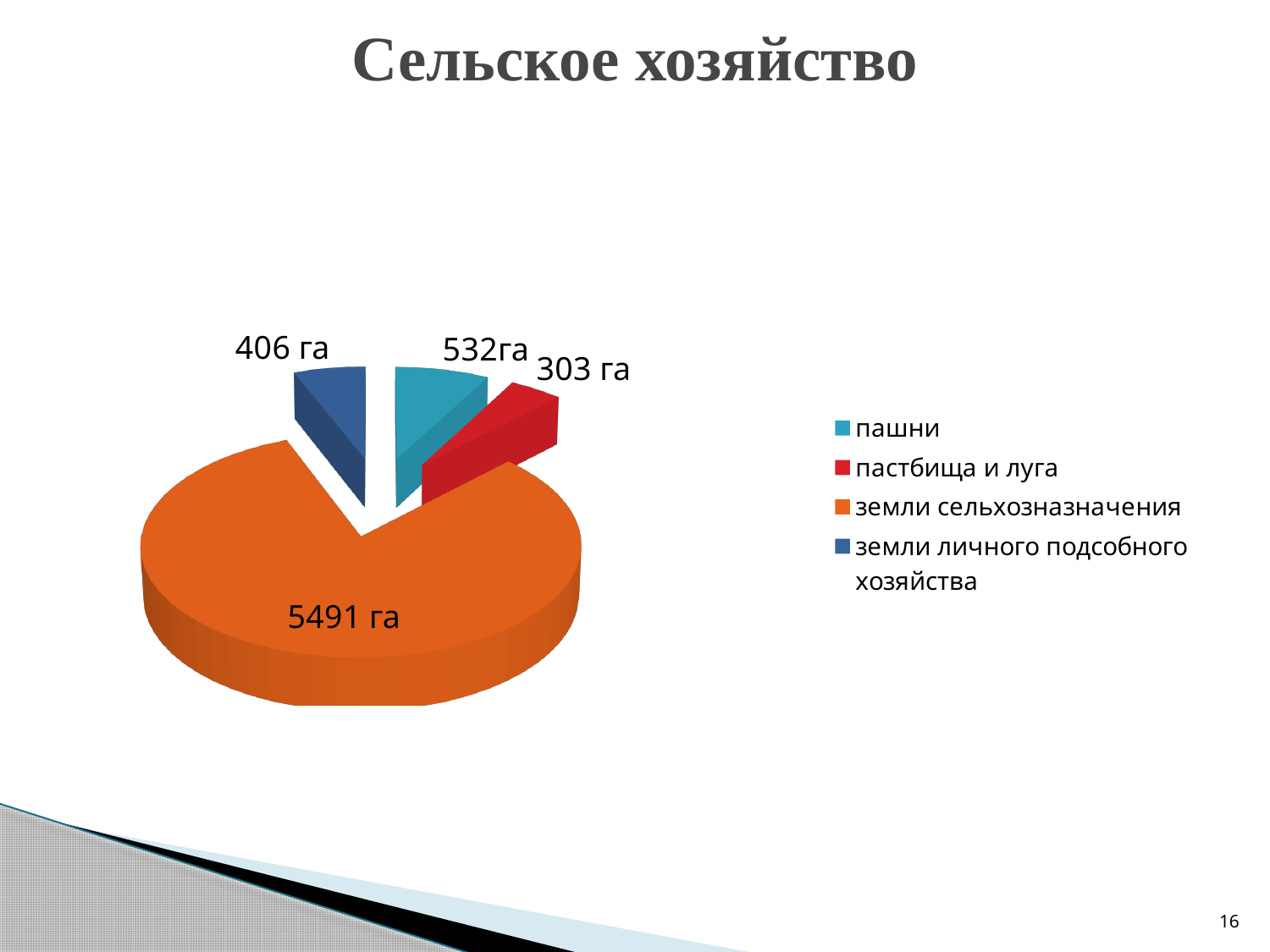
What type of chart is shown on the slide? pie chart What is the value shown for земли личного подсобного хозяйства? 406 га What is the difference between the values for земли сельхозназначения and земли личного подсобного хозяйства, in га? 5085 га What is the title of the slide containing the pie chart? Сельское хозяйство Which category has the smallest slice of the pie? пастбища и луга Which is larger, the value for пашни or the value for земли личного подсобного хозяйства? пашни Which category has the largest slice of the pie? земли сельхозназначения How many categories does the pie chart have? 4 What is the value shown for земли сельхозназначения? 5491 га What is the difference between the values for пашни and пастбища и луга, in га? 229 га What is the value shown for пастбища и луга? 303 га What is the value shown for пашни? 532га